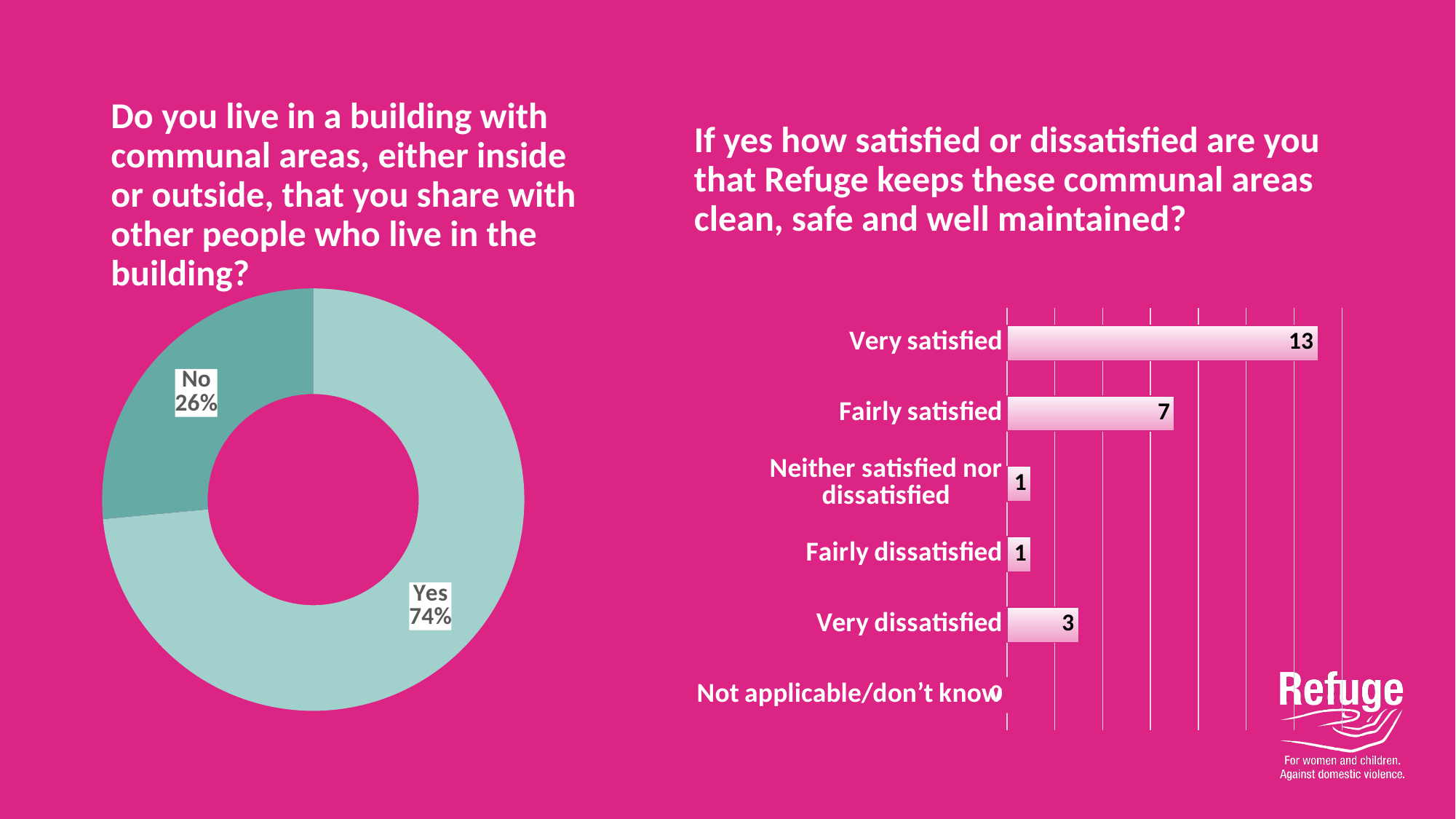
In the donut chart on the left, what percentage of respondents answered No? 26% In the bar chart on the right, what is the value for Very dissatisfied? 3 In the bar chart on the right, what is the value for Very satisfied? 13 In the bar chart on the right, what is the difference between Very satisfied and Fairly satisfied? 6 What type of chart is shown on the right side of the slide? Bar chart In the donut chart on the left, what percentage of respondents answered Yes? 74% In the bar chart on the right, which category has the highest value? Very satisfied In the donut chart on the left, which answer has the larger share, Yes or No? Yes In the bar chart on the right, which category has the lowest value? Not applicable/don't know In the bar chart on the right, what is the value for Fairly satisfied? 7 In the donut chart on the left, what is the difference in percentage points between Yes and No? 48 How many categories does the donut chart on the left show? 2